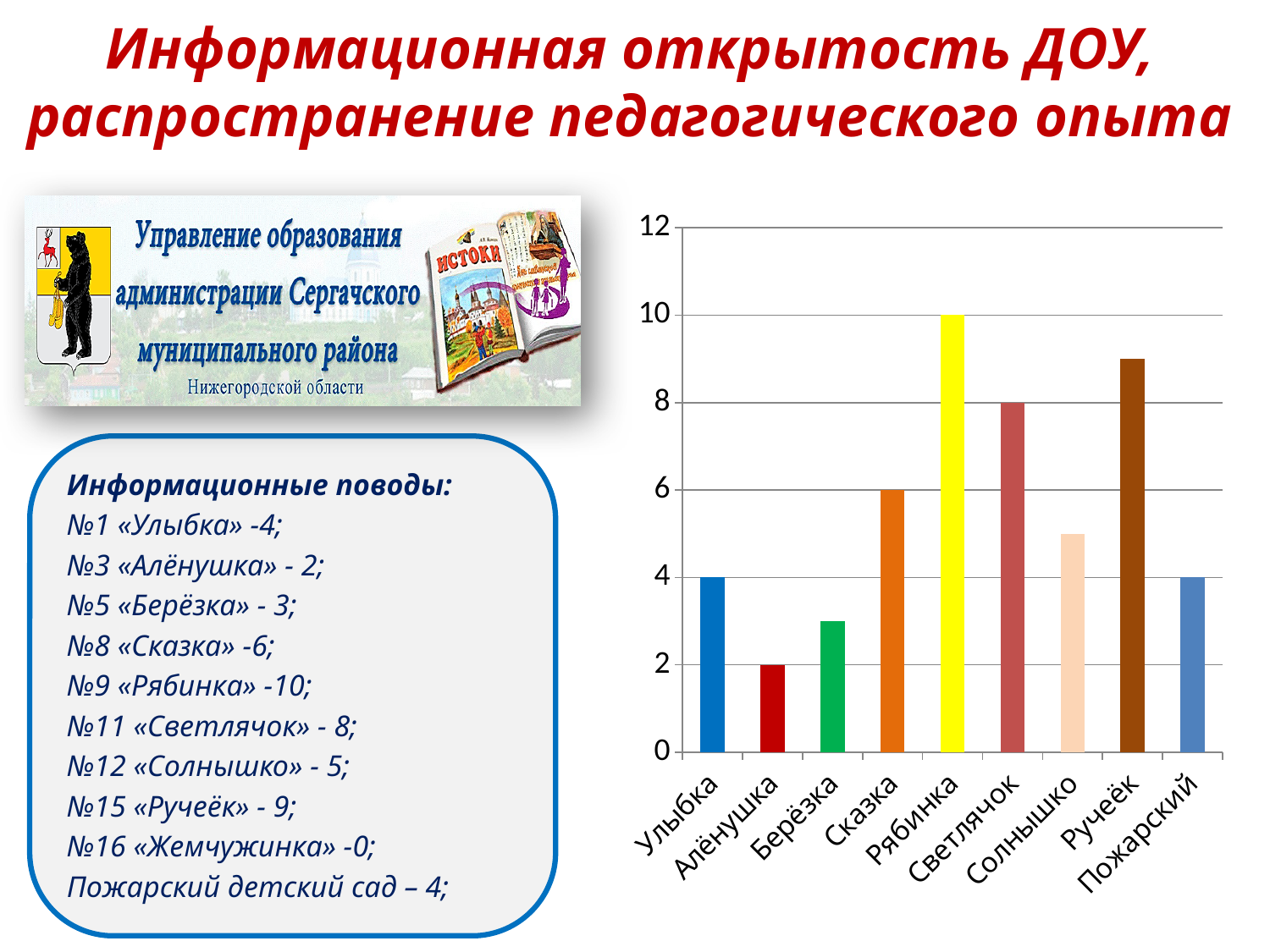
What is the value for Сказка in the chart? 6 Which is larger, the value for Сказка or the value for Улыбка? Сказка Which category has the lowest bar in the chart? Алёнушка What is the difference between the values for Рябинка and Светлячок? 2 What is the value for Рябинка in the chart? 10 What is the value for Светлячок in the chart? 8 How many categories are shown on the x axis of the chart? 9 Which category has the highest bar in the chart? Рябинка What is the value for Алёнушка in the chart? 2 What kind of chart is shown on the slide? bar chart Is the value for Ручеёк greater or less than 8? greater What colour is the bar for Рябинка? yellow